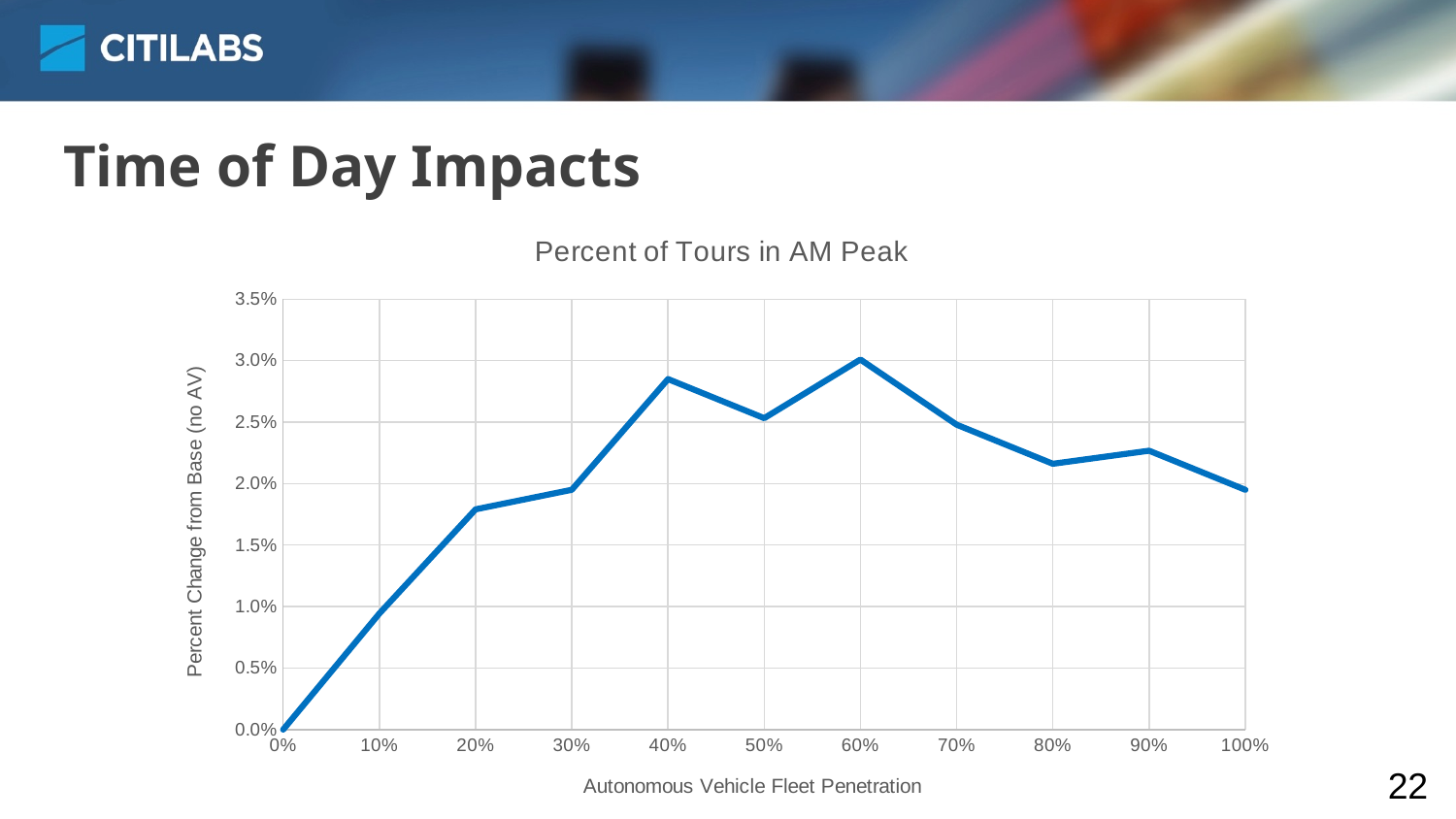
Is the value at 40% fleet penetration greater or less than 2.5%? greater What is the title of the chart? Percent of Tours in AM Peak What kind of chart is shown on the slide? line chart At which fleet penetration level is the percent change from base highest? 60% Does the line rise or fall between 0% and 40% fleet penetration? rise What is the value at 0% Autonomous Vehicle Fleet Penetration? 0.0% Is the value at 10% fleet penetration greater or less than 1.5%? less How many data points are plotted on the line? 11 Which has a larger value, 40% or 50% fleet penetration? 40% Is the value at 90% fleet penetration greater or less than 2.0%? greater What is the label of the x axis? Autonomous Vehicle Fleet Penetration At which fleet penetration level is the percent change from base lowest? 0%